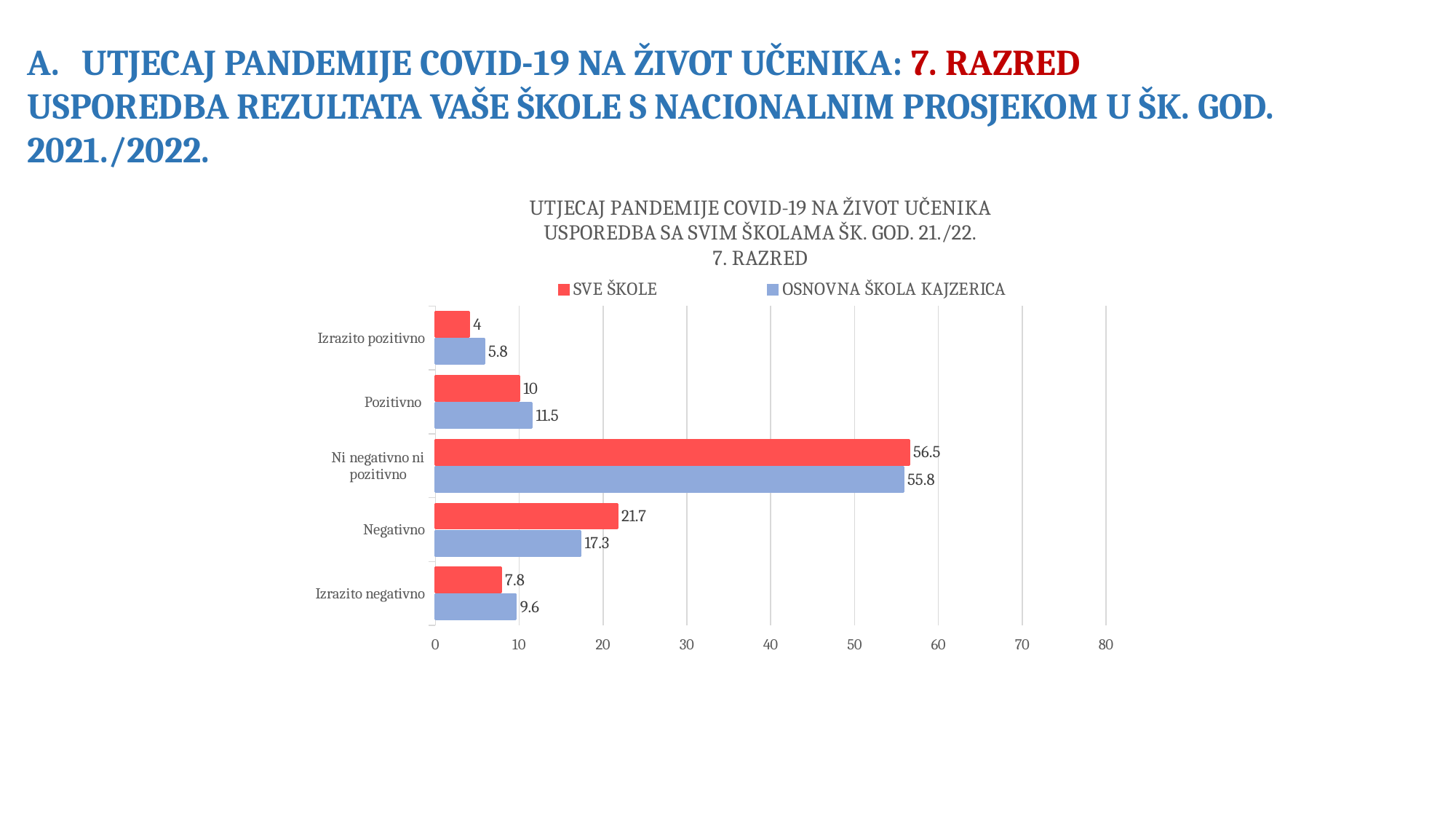
How many categories are shown on the chart? 5 What is the value for OSNOVNA ŠKOLA KAJZERICA in the Izrazito negativno category? 9.6 What colour are the bars for the SVE ŠKOLE series? red How many series does the legend list? 2 Which category has the lowest value for OSNOVNA ŠKOLA KAJZERICA? Izrazito pozitivno Is the value for SVE ŠKOLE in the Ni negativno ni pozitivno category greater or less than 50? greater What is the difference between the SVE ŠKOLE and OSNOVNA ŠKOLA KAJZERICA values in the Negativno category? 4.4 What kind of chart is shown on the slide? bar chart Which category has the highest value for SVE ŠKOLE? Ni negativno ni pozitivno In the Izrazito pozitivno category, which series has the larger value, SVE ŠKOLE or OSNOVNA ŠKOLA KAJZERICA? OSNOVNA ŠKOLA KAJZERICA What is the value for SVE ŠKOLE in the Negativno category? 21.7 What is the value for OSNOVNA ŠKOLA KAJZERICA in the Pozitivno category? 11.5